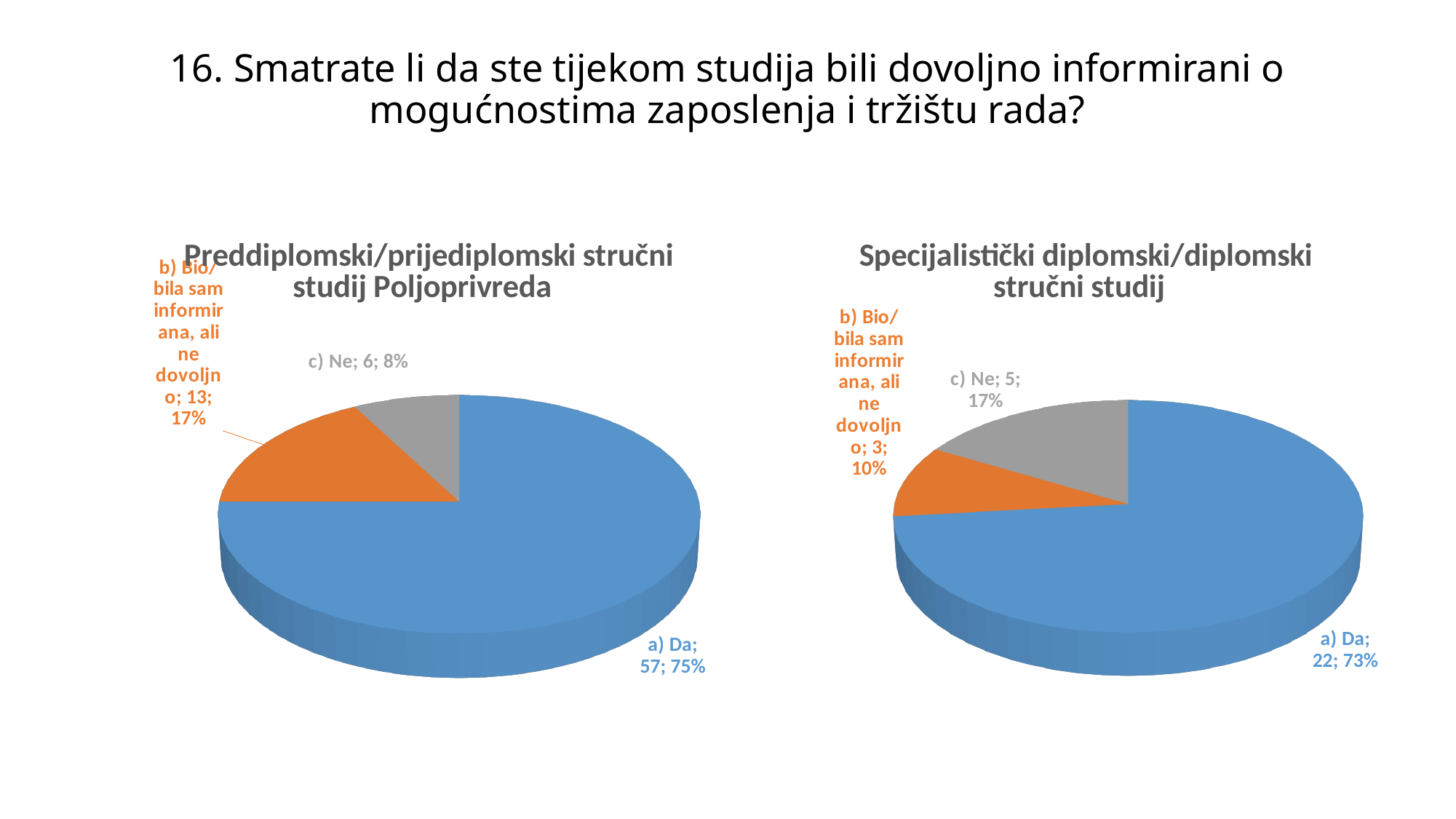
Which chart has the larger count for "a) Da", the left chart or the right chart? The left chart In the left chart (Preddiplomski/prijediplomski stručni studij Poljoprivreda), which answer has the smallest slice? c) Ne In the left chart (Preddiplomski/prijediplomski stručni studij Poljoprivreda), how many respondents chose "b) Bio/bila sam informirana, ali ne dovoljno"? 13 In the left chart (Preddiplomski/prijediplomski stručni studij Poljoprivreda), what is the difference in count between "a) Da" and "c) Ne"? 51 In the left chart (Preddiplomski/prijediplomski stručni studij Poljoprivreda), what share of the pie is "c) Ne"? 8% In the left chart (Preddiplomski/prijediplomski stručni studij Poljoprivreda), how many respondents answered "a) Da"? 57 In the right chart (Specijalistički diplomski/diplomski stručni studij), which answer has the smallest slice? b) Bio/bila sam informirana, ali ne dovoljno In the right chart (Specijalistički diplomski/diplomski stručni studij), what share of the pie is "c) Ne"? 17% In the right chart (Specijalistički diplomski/diplomski stručni studij), how many respondents answered "a) Da"? 22 What kind of chart is used on the left, titled "Preddiplomski/prijediplomski stručni studij Poljoprivreda"? Pie chart In the right chart (Specijalistički diplomski/diplomski stručni studij), how many slices does the pie have? 3 In the left chart (Preddiplomski/prijediplomski stručni studij Poljoprivreda), which answer has the largest slice? a) Da